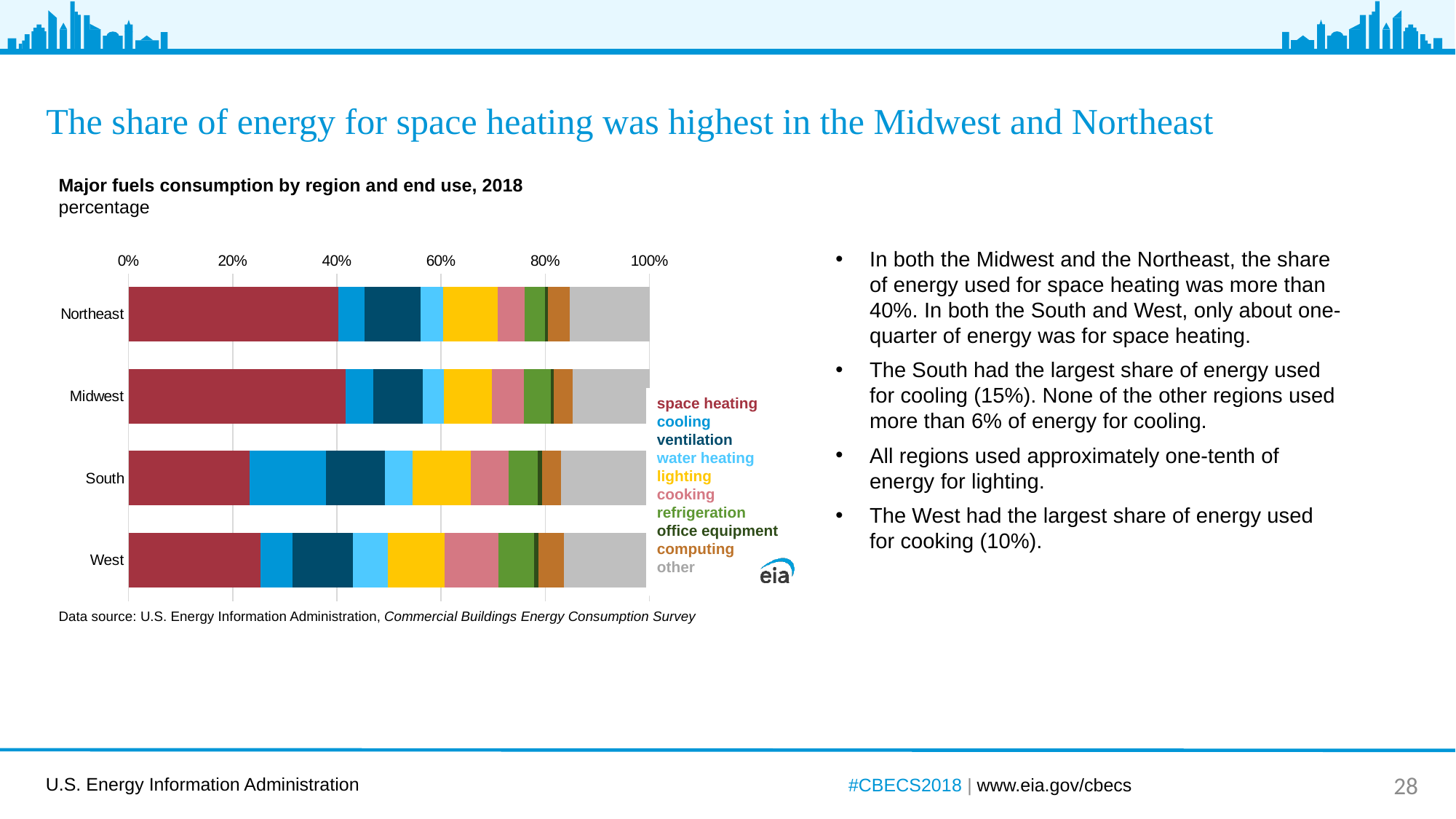
Is the space heating share for the South greater or less than 40%? less How many regions are plotted in the chart? 4 Which end use is listed last in the chart legend? other Is the share of energy for cooling larger in the South or in the Midwest? South Which region has the largest share of energy used for cooking? West How many end-use series does the legend list? 10 Which region has the largest share of energy used for cooling? South What is the title of the chart? Major fuels consumption by region and end use, 2018 Is the share of energy for space heating larger in the Northeast or in the South? Northeast What kind of chart is shown on the slide? stacked bar chart Is the space heating share for the Midwest greater or less than 20%? greater Is the space heating share for the West greater or less than 20%? greater